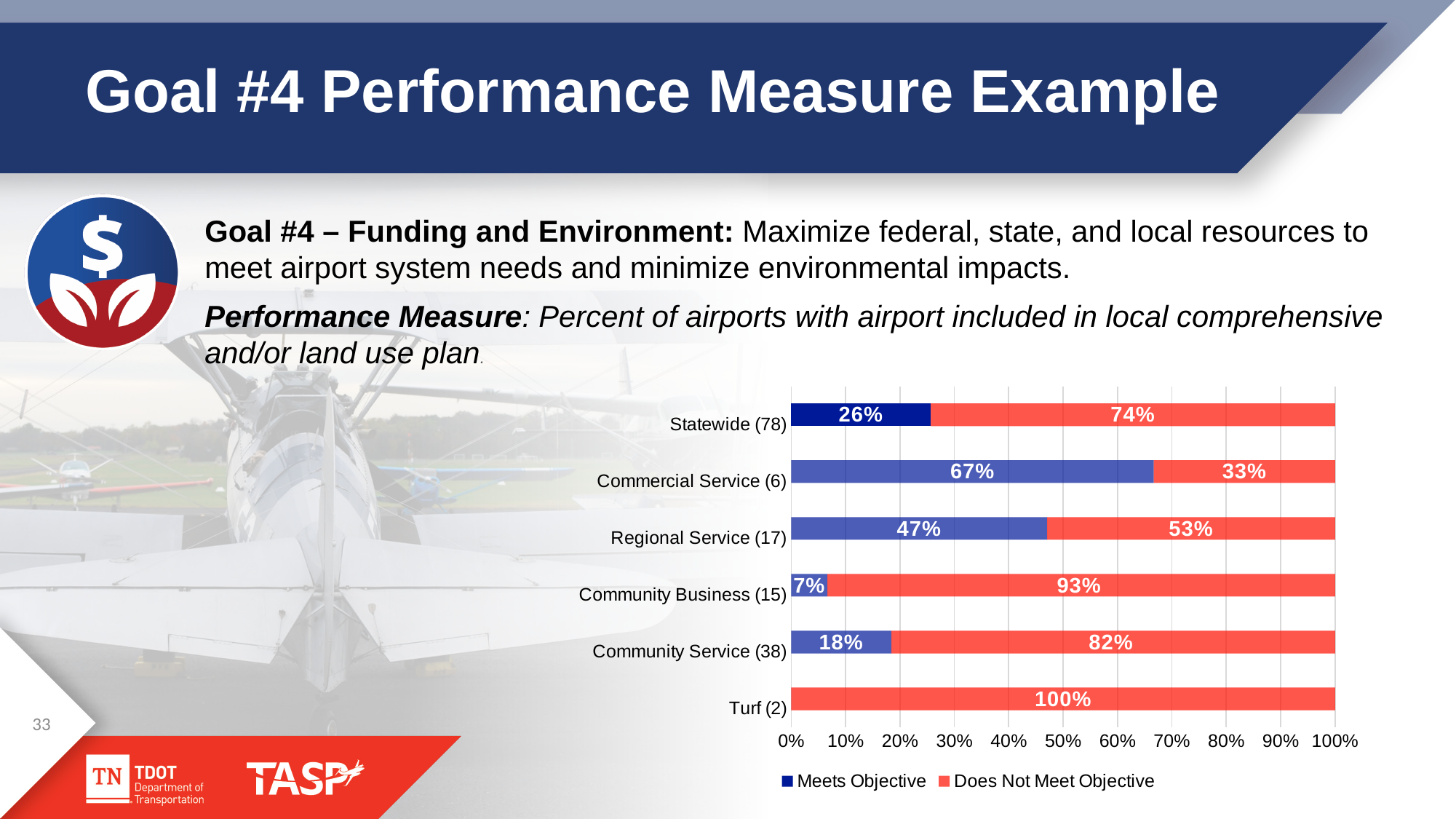
What is the difference between the Does Not Meet Objective values for Community Service (38) and Statewide (78)? 8% What is the Meets Objective value for Regional Service (17)? 47% What is the Meets Objective value for Statewide (78)? 26% How many categories are shown on the chart? 6 Which category has the lowest Does Not Meet Objective value? Commercial Service (6) Which colour represents Does Not Meet Objective in the legend? Red What kind of chart is shown on the slide? Stacked bar chart Which is larger: the Meets Objective value for Community Service (38) or for Community Business (15)? Community Service (38) What is the Does Not Meet Objective value for Community Business (15)? 93% What is the Does Not Meet Objective value for Turf (2)? 100% Which category has the highest Meets Objective value? Commercial Service (6) How many series does the legend list? 2